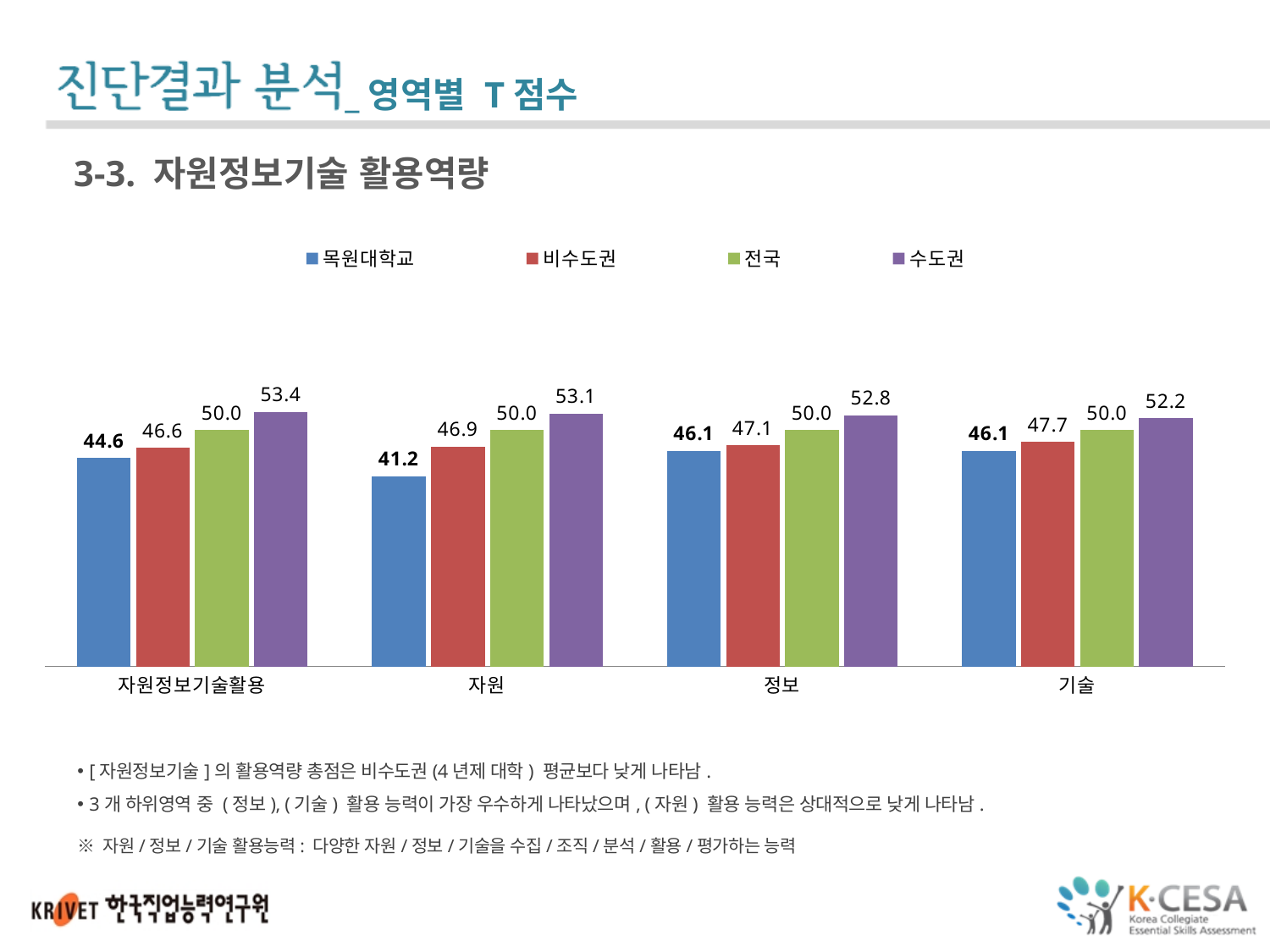
How many series does the legend list? 4 What is the value for 수도권 in the 자원정보기술활용 category? 53.4 In which category does 목원대학교 have its lowest value? 자원 What kind of chart is shown on the slide? bar chart What is the value for 비수도권 in the 기술 category? 47.7 What is the difference between the 수도권 and 목원대학교 values in the 자원 category? 11.9 Which series is shown in green in the legend? 전국 Which series has the highest value in the 정보 category? 수도권 Which is larger: the 수도권 value for 자원정보기술활용 or the 수도권 value for 기술? 자원정보기술활용 What is the value for 목원대학교 in the 자원 category? 41.2 What is the difference between the 비수도권 and 목원대학교 values in the 자원정보기술활용 category? 2.0 How many categories are shown on the x axis? 4